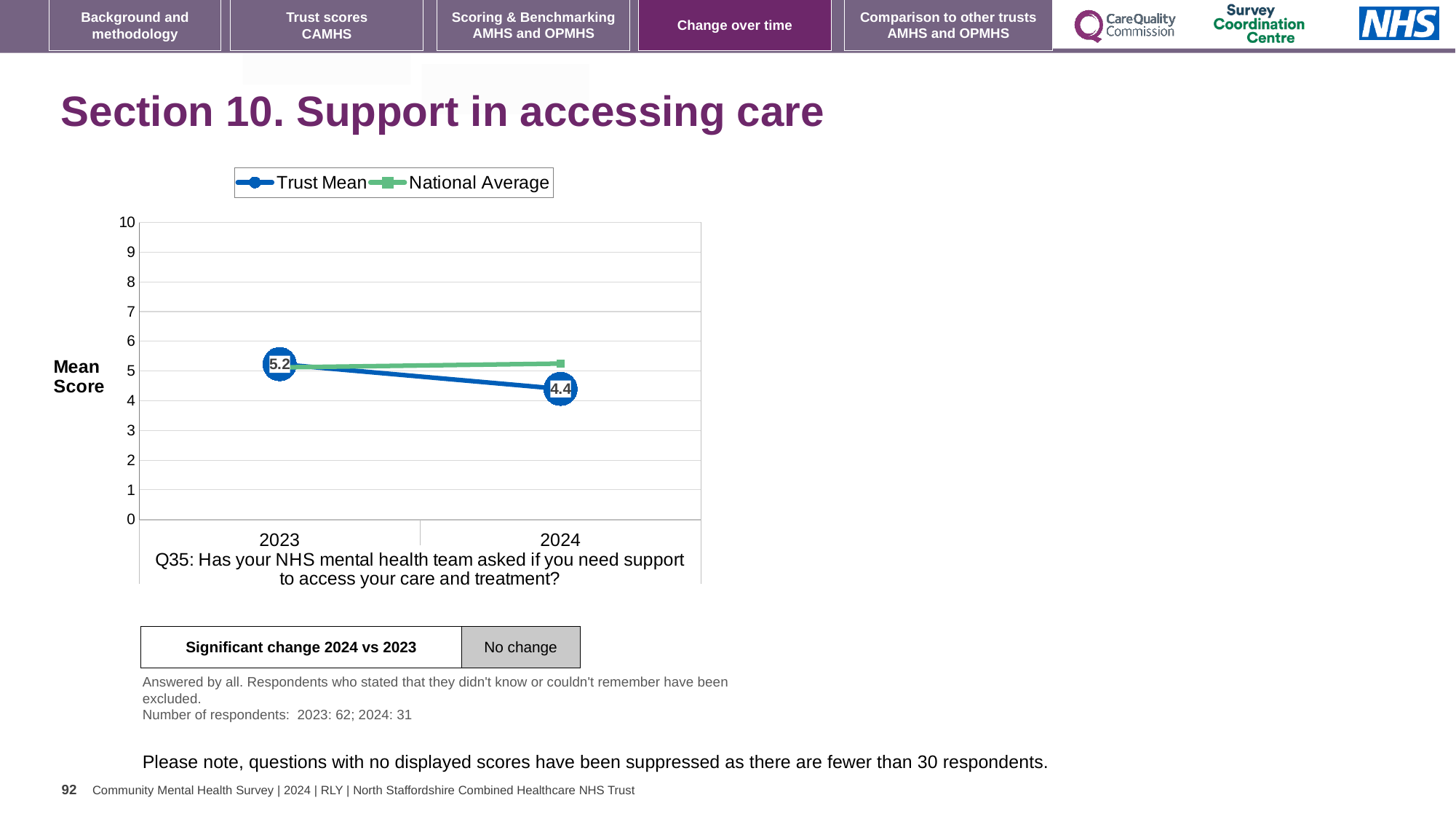
Is the National Average value for 2024 greater or less than 6? less Does the Trust Mean rise or fall from 2023 to 2024? Fall What is the Trust Mean score for 2024? 4.4 How many years are shown on the x axis of the chart? 2 In 2024, which is larger: the Trust Mean or the National Average? National Average In which year is the Trust Mean score lowest? 2024 In which year is the Trust Mean score highest? 2023 Is the National Average value for 2023 greater or less than 4? greater How many series does the chart legend list? 2 What is the difference between the Trust Mean score in 2023 and in 2024? 0.8 What is the Trust Mean score for 2023? 5.2 What kind of chart is shown on the slide? Line chart